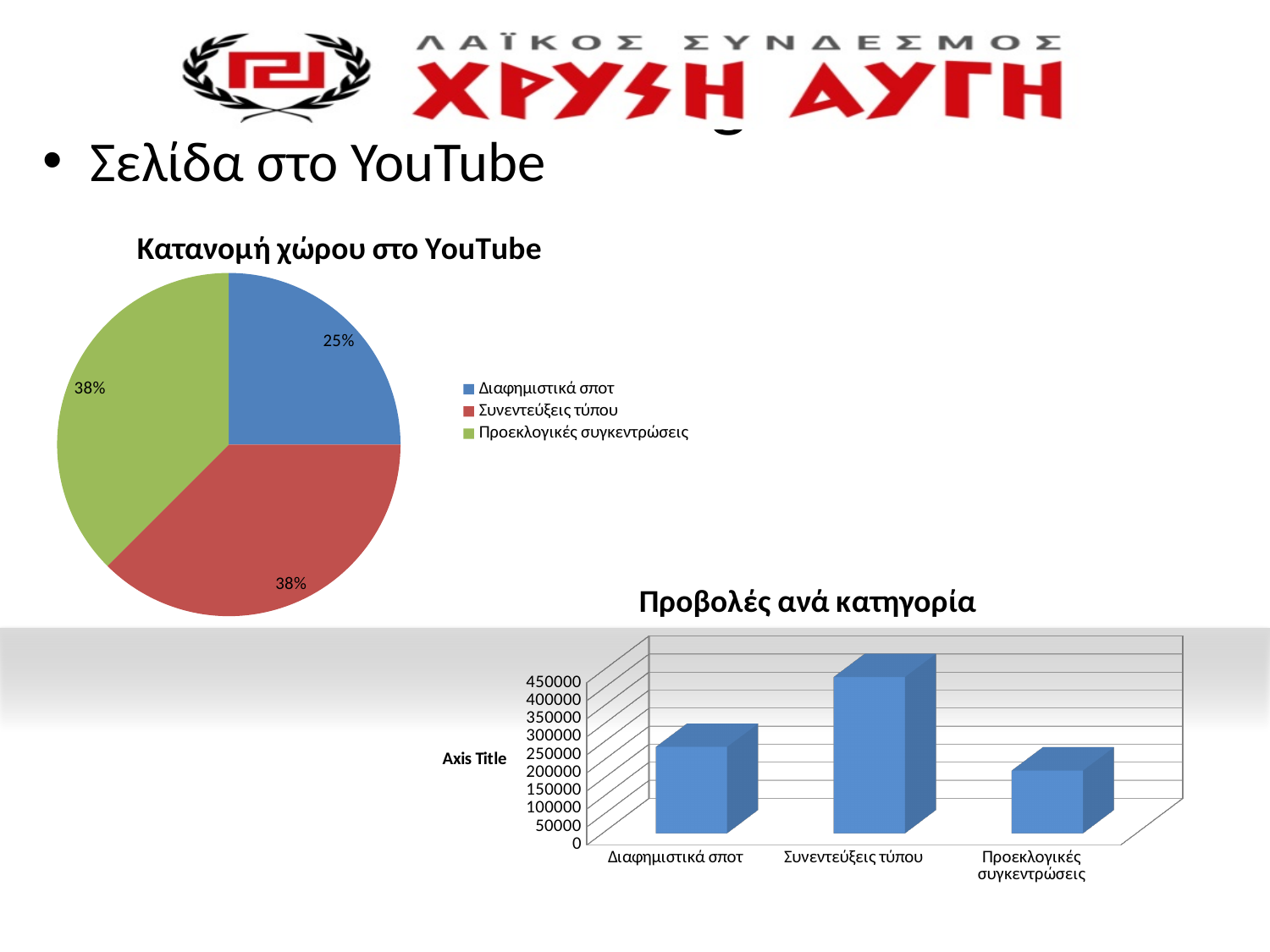
In the pie chart 'Κατανομή χώρου στο YouTube', which category has the smallest slice? Διαφημιστικά σποτ In the chart 'Προβολές ανά κατηγορία', is the value for Συνεντεύξεις τύπου greater or less than 350000? greater In the chart 'Προβολές ανά κατηγορία', which category has the highest value? Συνεντεύξεις τύπου What kind of chart is 'Προβολές ανά κατηγορία'? Bar chart In the pie chart 'Κατανομή χώρου στο YouTube', what share does Προεκλογικές συγκεντρώσεις have? 38% In the chart 'Προβολές ανά κατηγορία', which category has the lowest value? Προεκλογικές συγκεντρώσεις In the pie chart 'Κατανομή χώρου στο YouTube', how many categories does the legend list? 3 What kind of chart is 'Κατανομή χώρου στο YouTube'? Pie chart In the chart 'Προβολές ανά κατηγορία', is the value for Διαφημιστικά σποτ greater or less than 300000? less In the pie chart 'Κατανομή χώρου στο YouTube', what colour is the Προεκλογικές συγκεντρώσεις slice? Green In the pie chart 'Κατανομή χώρου στο YouTube', what share does Συνεντεύξεις τύπου have? 38% In the pie chart 'Κατανομή χώρου στο YouTube', what share does Διαφημιστικά σποτ have? 25%